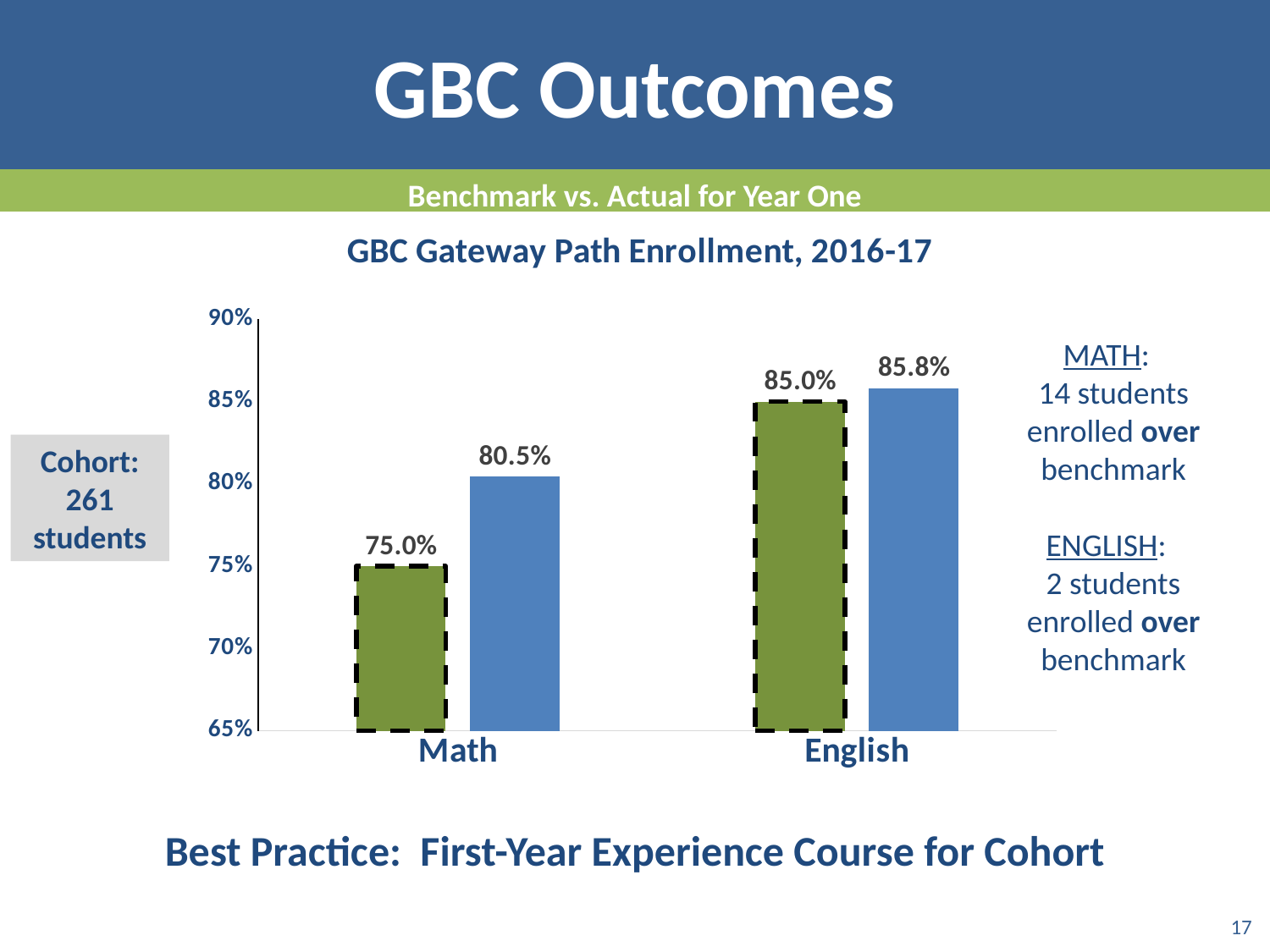
Which bar in the chart has the highest value? The blue bar for English (85.8%) What is the difference between the blue bar and the green bar for Math? 5.5% Which bar in the chart has the lowest value? The green bar for Math (75.0%) How many categories are shown on the x axis of the chart? 2 What is the value of the green bar for English? 85.0% What kind of chart is shown on the slide? Bar chart What is the difference between the blue bar and the green bar for English? 0.8% For Math, which is larger: the green bar or the blue bar? The blue bar (80.5%) What is the title of the chart? GBC Gateway Path Enrollment, 2016-17 What is the value of the green bar for Math in the GBC Gateway Path Enrollment chart? 75.0% What is the value of the blue bar for Math? 80.5% What is the value of the blue bar for English? 85.8%